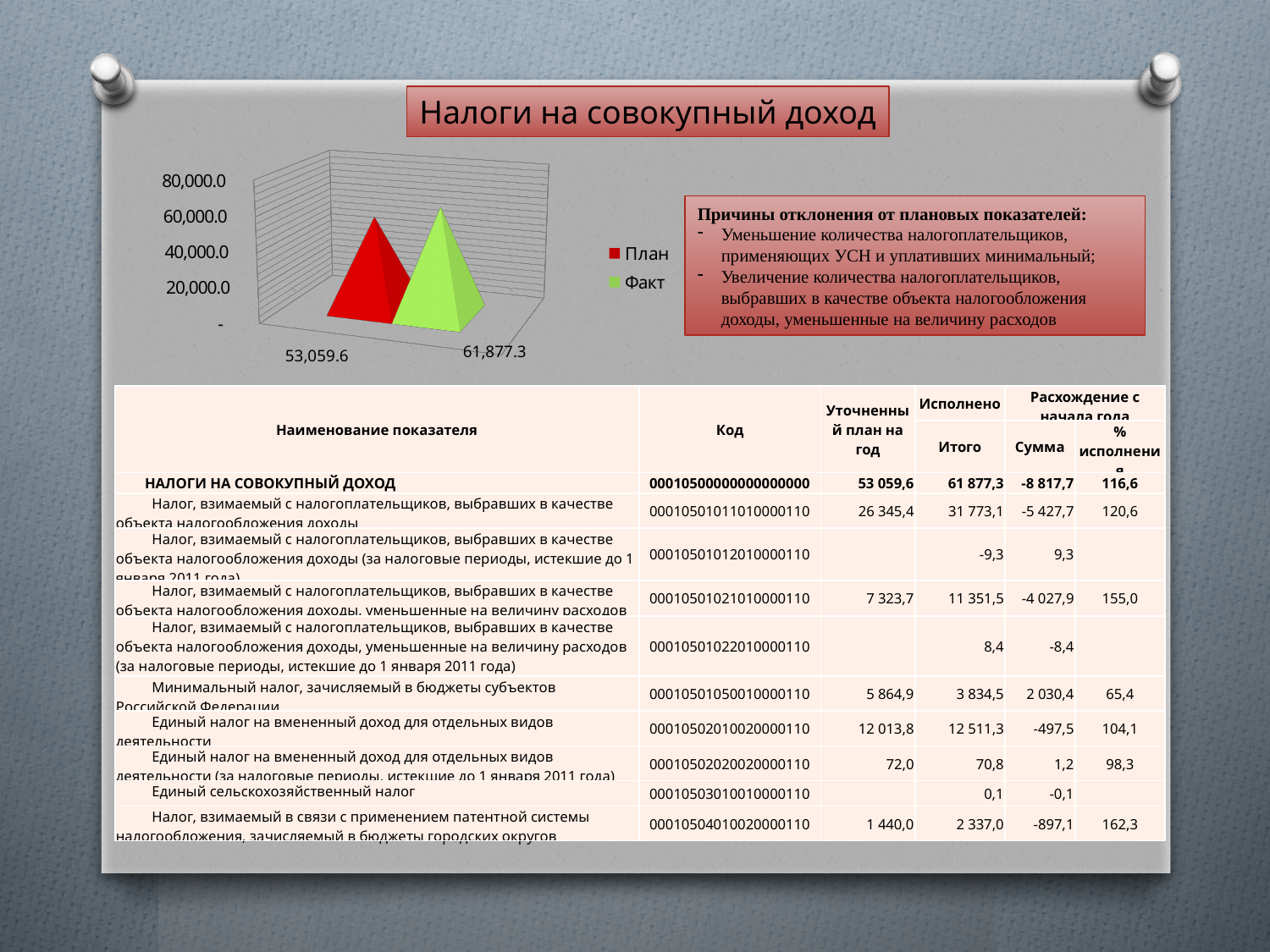
How many bars are plotted in the chart? 2 Is the value for План greater or less than 40,000.0? greater Which series shows the lowest value in the chart? План Which colour represents the Факт series in the chart? green What kind of chart is shown on the slide? bar chart How many series does the chart legend list? 2 Which series has the taller bar in the chart, План or Факт? Факт Is the value for Факт greater or less than 40,000.0? greater Which series shows the highest value in the chart? Факт Is the value for Факт greater or less than 80,000.0? less What are the two series named in the chart legend? План and Факт